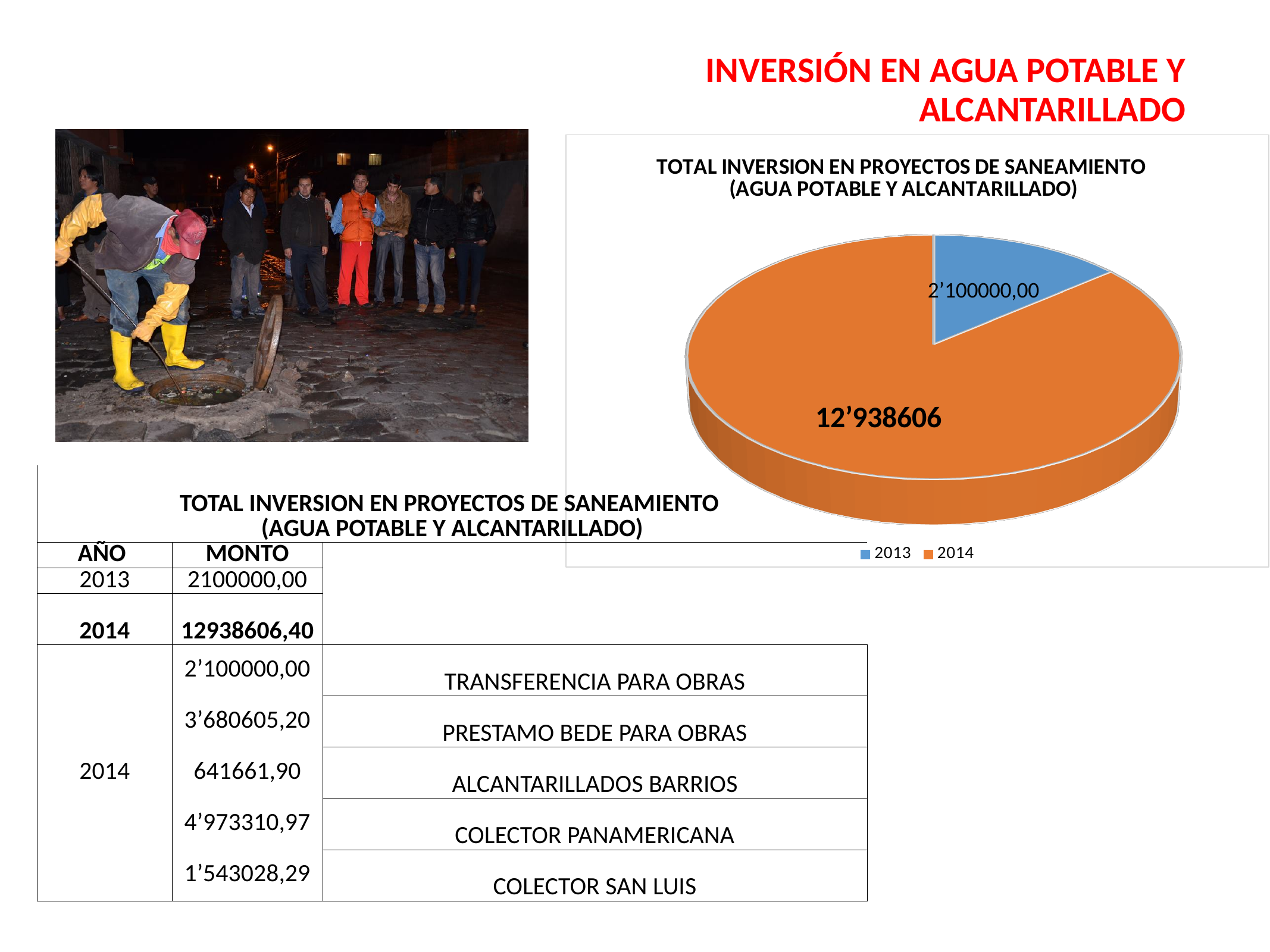
What kind of chart is shown on the slide? Pie chart Which year has the smallest slice in the pie chart? 2013 How many slices does the pie chart have? 2 Which year has the largest slice in the pie chart? 2014 How many entries does the legend of the pie chart list? 2 What value is shown for the 2013 slice of the pie chart? 2’100000,00 Which is larger in the pie chart, the value for 2013 or the value for 2014? 2014 What is the title of the pie chart? TOTAL INVERSION EN PROYECTOS DE SANEAMIENTO (AGUA POTABLE Y ALCANTARILLADO) Which colour represents 2014 in the pie chart? Orange What value is shown for the 2014 slice of the pie chart? 12’938606